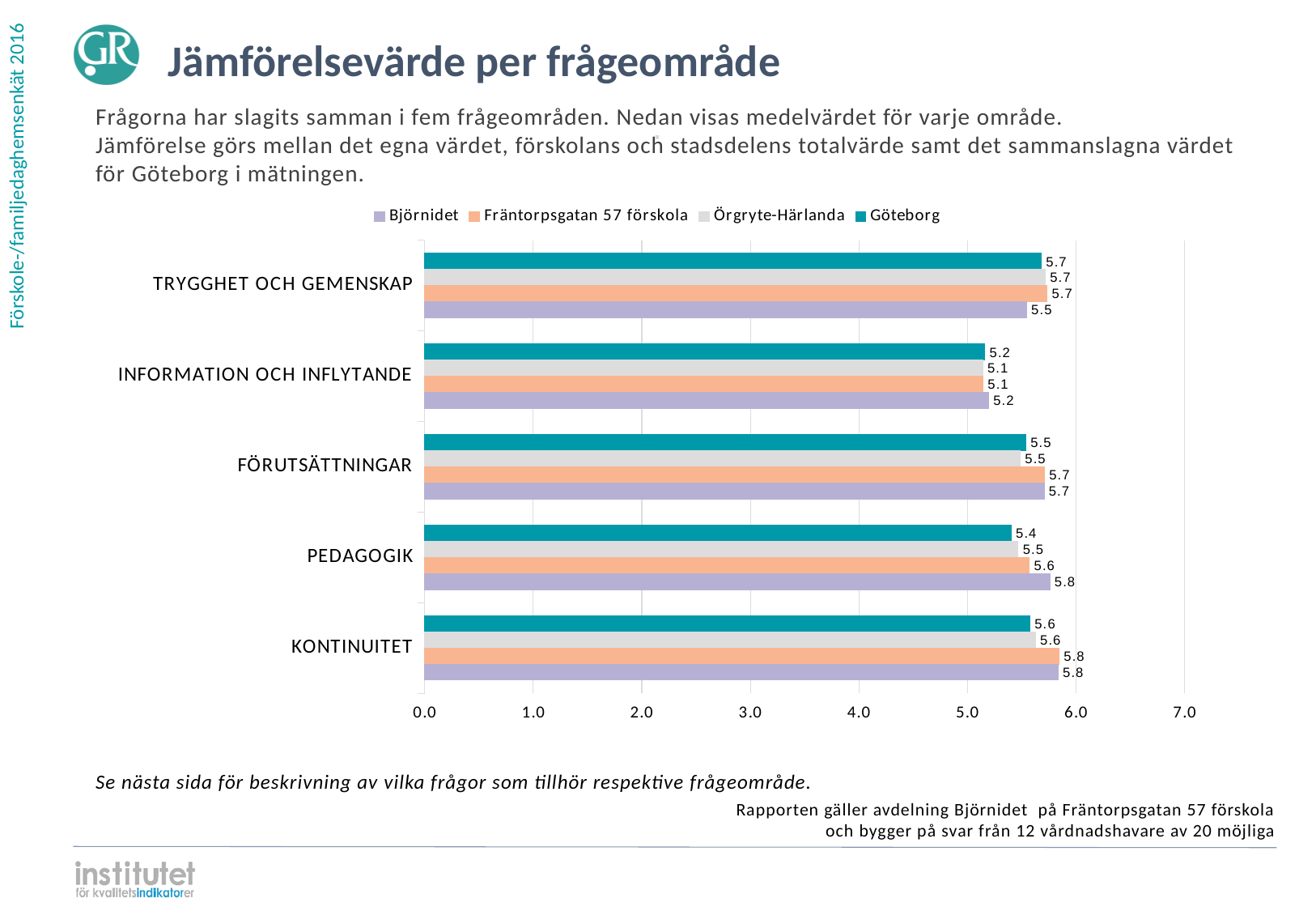
In which category does Göteborg have its highest value? TRYGGHET OCH GEMENSKAP In which category does Björnidet have its lowest value? INFORMATION OCH INFLYTANDE What is the value for Göteborg in the INFORMATION OCH INFLYTANDE category? 5.2 What is the title of the slide containing the chart? Jämförelsevärde per frågeområde What is the value for Björnidet in the PEDAGOGIK category? 5.8 How many categories (frågeområden) are shown on the chart? 5 What is the value for Örgryte-Härlanda in the FÖRUTSÄTTNINGAR category? 5.5 What is the difference between the Björnidet value and the Göteborg value in the PEDAGOGIK category? 0.4 In the TRYGGHET OCH GEMENSKAP category, which is larger: the value for Björnidet or the value for Göteborg? Göteborg What kind of chart is shown on the slide? Bar chart What is the value for Fräntorpsgatan 57 förskola in the KONTINUITET category? 5.8 How many series does the legend list? 4